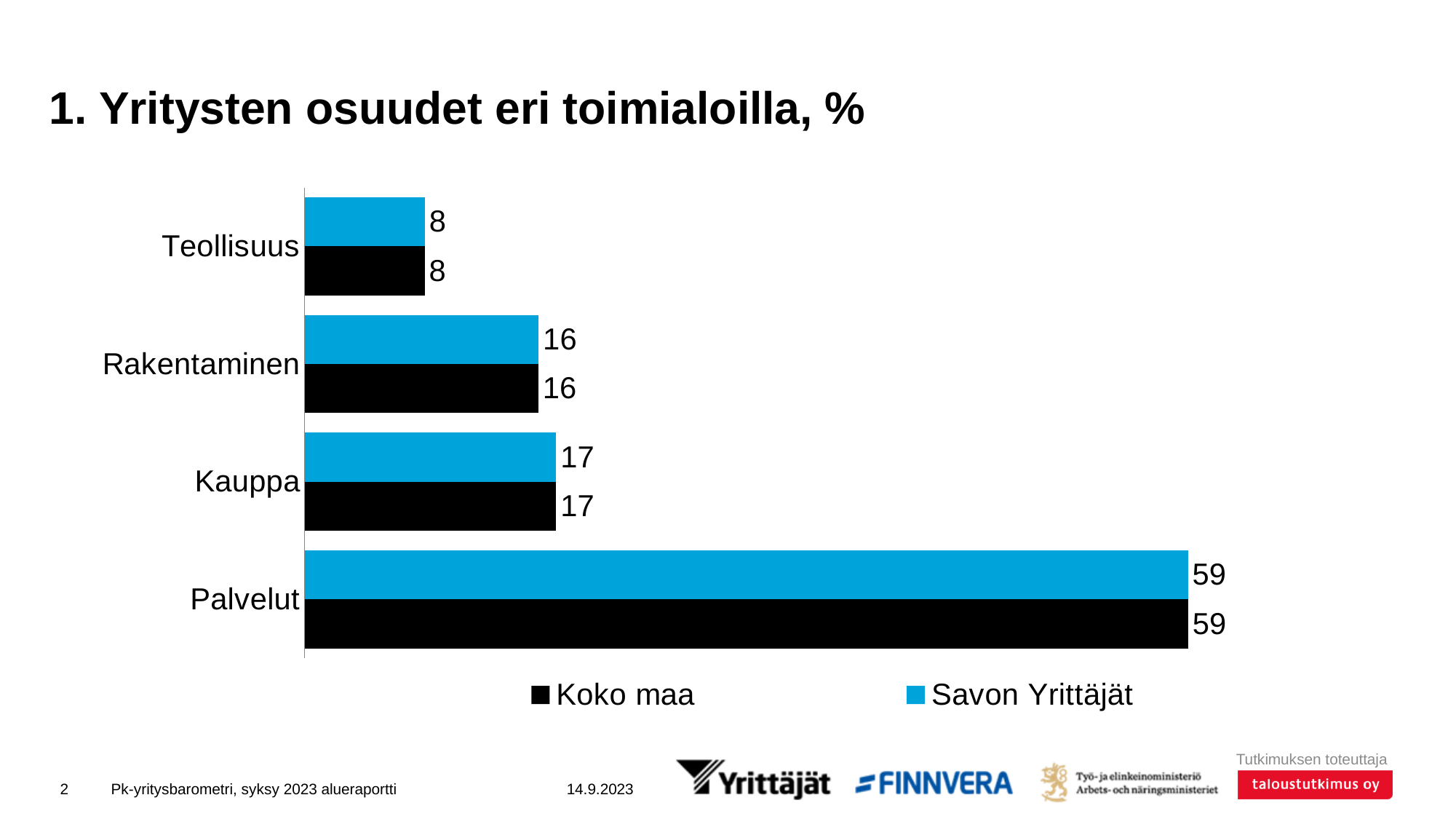
What is the value for Rakentaminen in the Koko maa series? 16 How many series does the legend list? 2 How many categories are shown on the chart? 4 What is the value for Kauppa in the Savon Yrittäjät series? 17 Which is larger in the Savon Yrittäjät series, Palvelut or Rakentaminen? Palvelut Which category has the lowest value in the Koko maa series? Teollisuus What is the value for Palvelut in the Koko maa series? 59 What is the difference between Palvelut and Kauppa in the Koko maa series? 42 What kind of chart is shown on the slide? Bar chart Which category has the highest value in the Savon Yrittäjät series? Palvelut What is the value for Teollisuus in the Savon Yrittäjät series? 8 What is the difference between Rakentaminen and Teollisuus in the Savon Yrittäjät series? 8